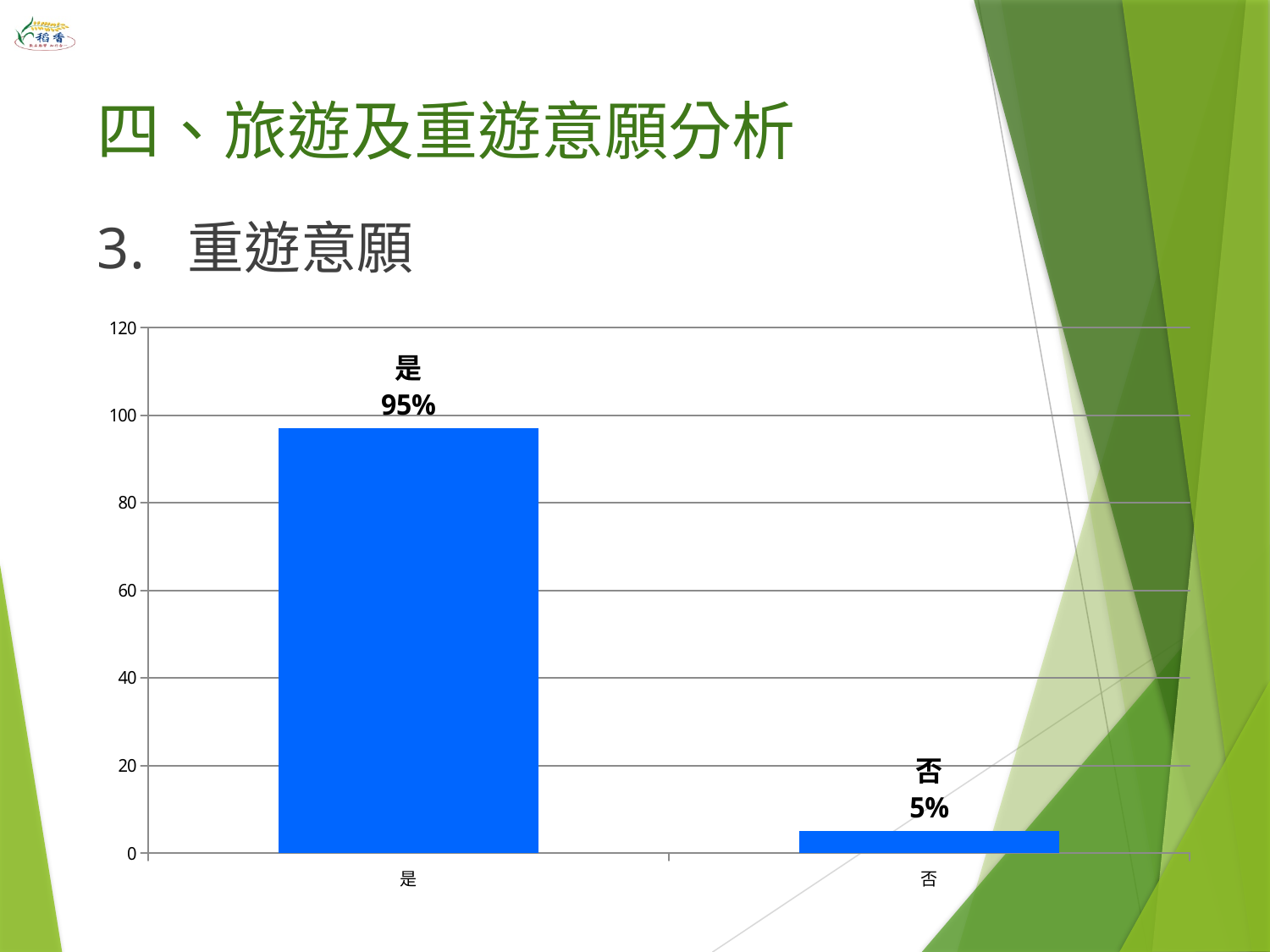
Is the bar for 否 greater or less than 20 on the axis? less What is the value shown for 否 (no) in the chart? 5% How many categories are shown in the chart? 2 What kind of chart is shown on the slide? bar chart Is the bar for 是 greater or less than 80 on the axis? greater What is the value shown for 是 (yes) in the chart? 95% Which category has the highest value in the chart? 是 Which category has the lowest value in the chart? 否 What is the maximum value shown on the vertical axis of the chart? 120 What is the heading directly above the chart? 3. 重遊意願 What is the difference between the values labelled for 是 and 否? 90% Which is larger, the value for 是 or the value for 否? 是